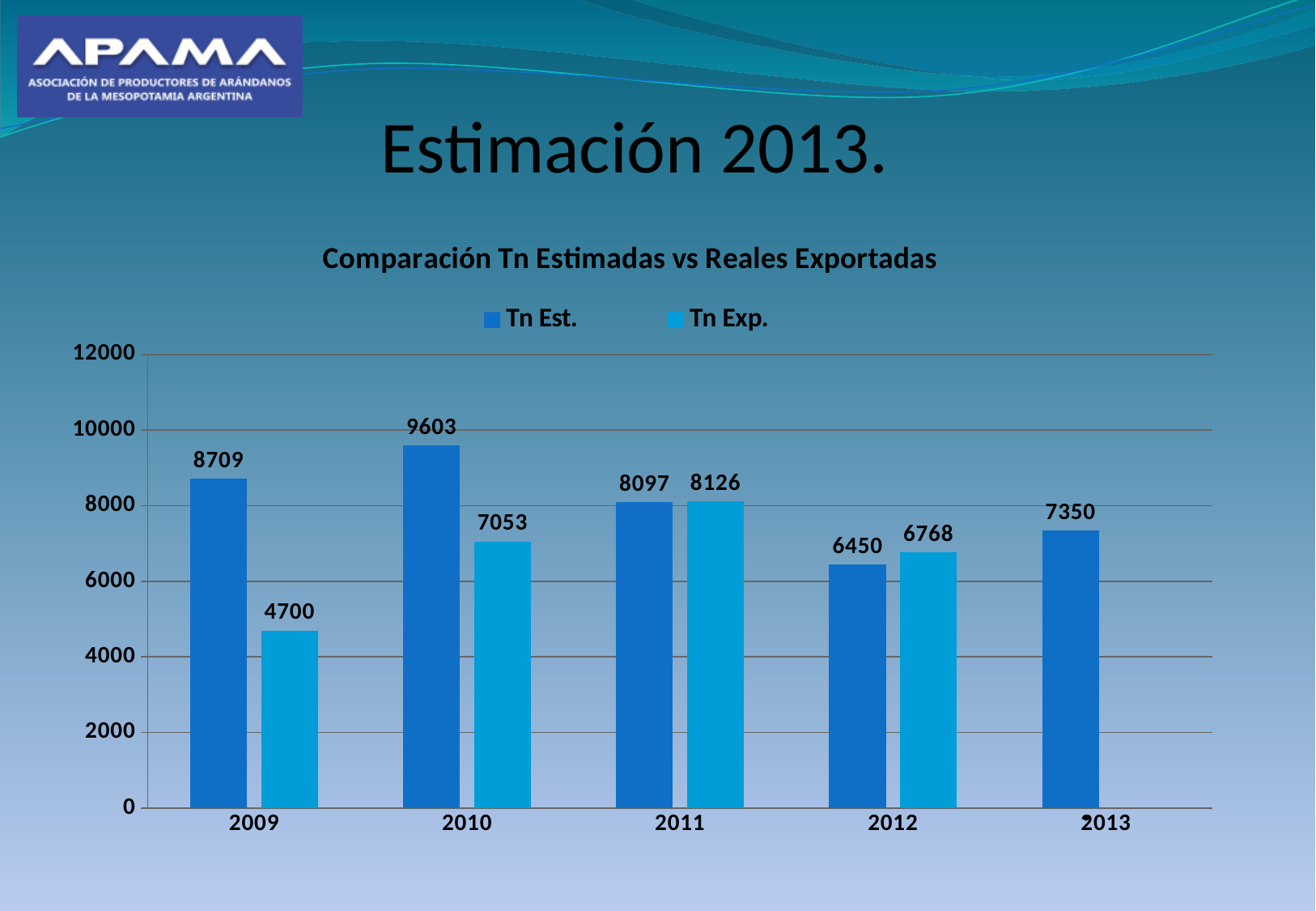
Which year has the lowest Tn Exp. value? 2009 How many series does the legend list? 2 What is the title of the chart? Comparación Tn Estimadas vs Reales Exportadas What is the difference between Tn Est. and Tn Exp. in 2009? 4009 In 2010, which is larger, Tn Est. or Tn Exp.? Tn Est. What is the Tn Exp. value for 2009? 4700 How many years are shown on the x axis? 5 What is the Tn Est. value for 2010? 9603 What is the difference between Tn Exp. and Tn Est. in 2012? 318 What is the Tn Est. value for 2013? 7350 What kind of chart is shown on the slide? Bar chart Which year has the highest Tn Est. value? 2010